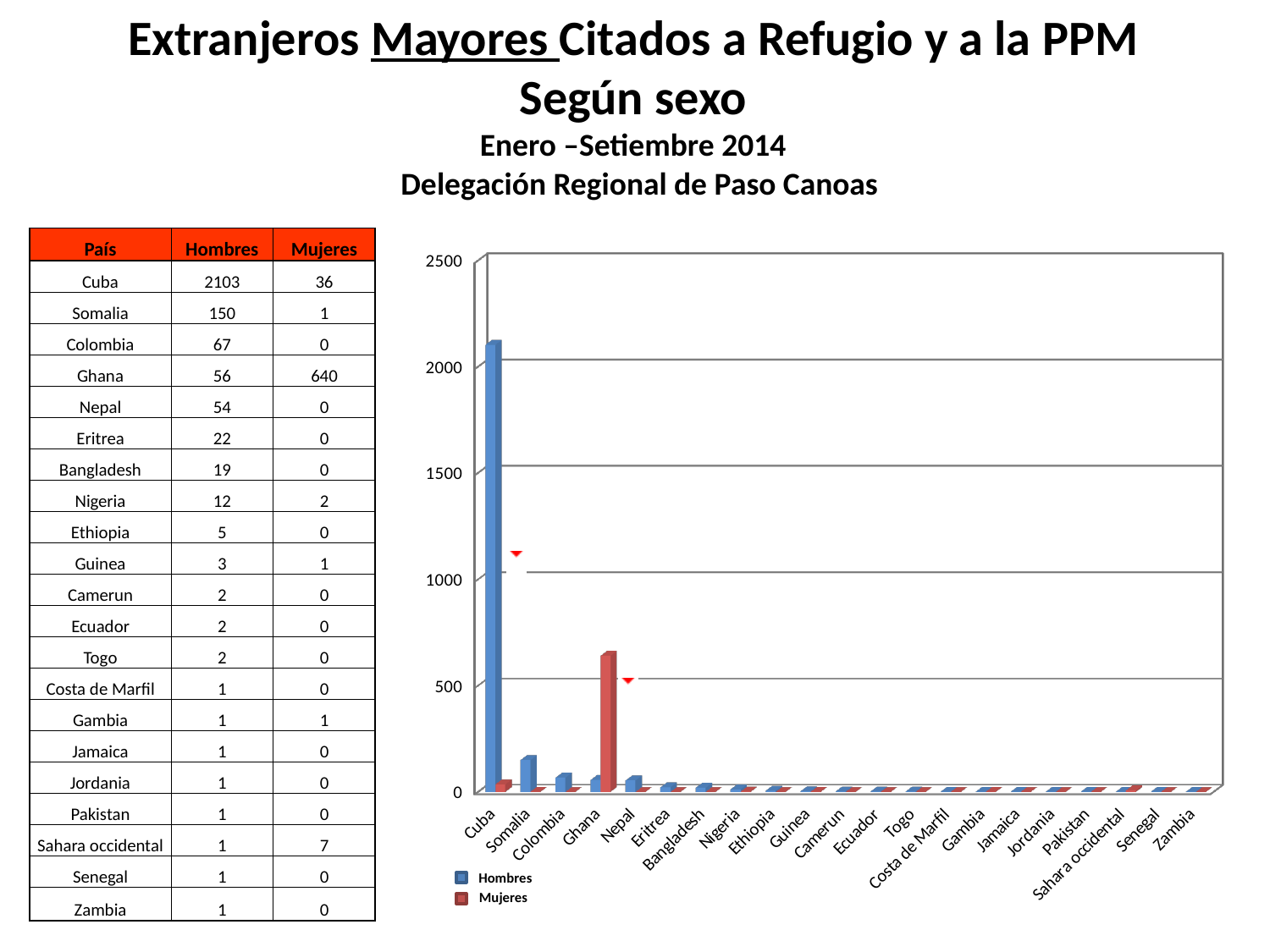
What is the total of Hombres and Mujeres for Cuba? 2139 Which country has the highest Hombres value? Cuba How many countries are plotted along the x axis of the chart? 21 What colour represents the Hombres series in the chart? blue Is the Hombres value for Cuba greater or less than 2000? greater What is the Hombres value for Cuba? 2103 Which country has the highest Mujeres value? Ghana What kind of chart is shown on the slide? bar chart For Ghana, which is larger, Hombres or Mujeres? Mujeres How many series does the chart's legend list? 2 What is the difference between the Hombres values for Cuba and Somalia? 1953 What is the Mujeres value for Ghana? 640